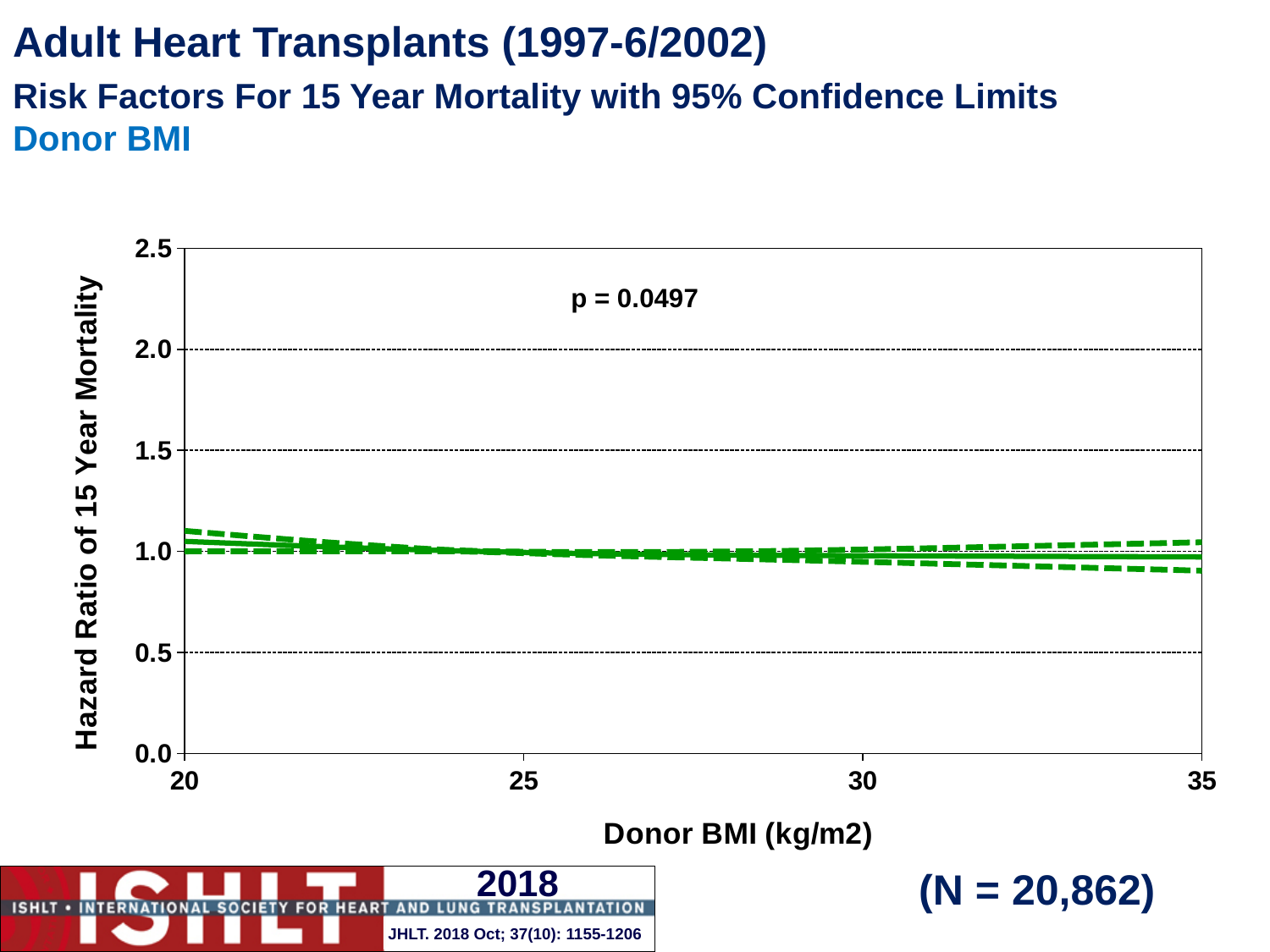
What is the p-value shown on the chart? p = 0.0497 Is the hazard ratio at a donor BMI of 35 greater or less than 0.5? greater What is the sample size (N) shown on the slide? N = 20,862 What kind of chart is shown on the slide? line chart Does the solid hazard ratio line rise or fall as donor BMI increases from 20 to 35? fall How many lines are plotted on the chart? 3 Is the upper confidence limit at a donor BMI of 30 greater or less than 1.5? less Is the hazard ratio at a donor BMI of 25 greater or less than 1.5? less